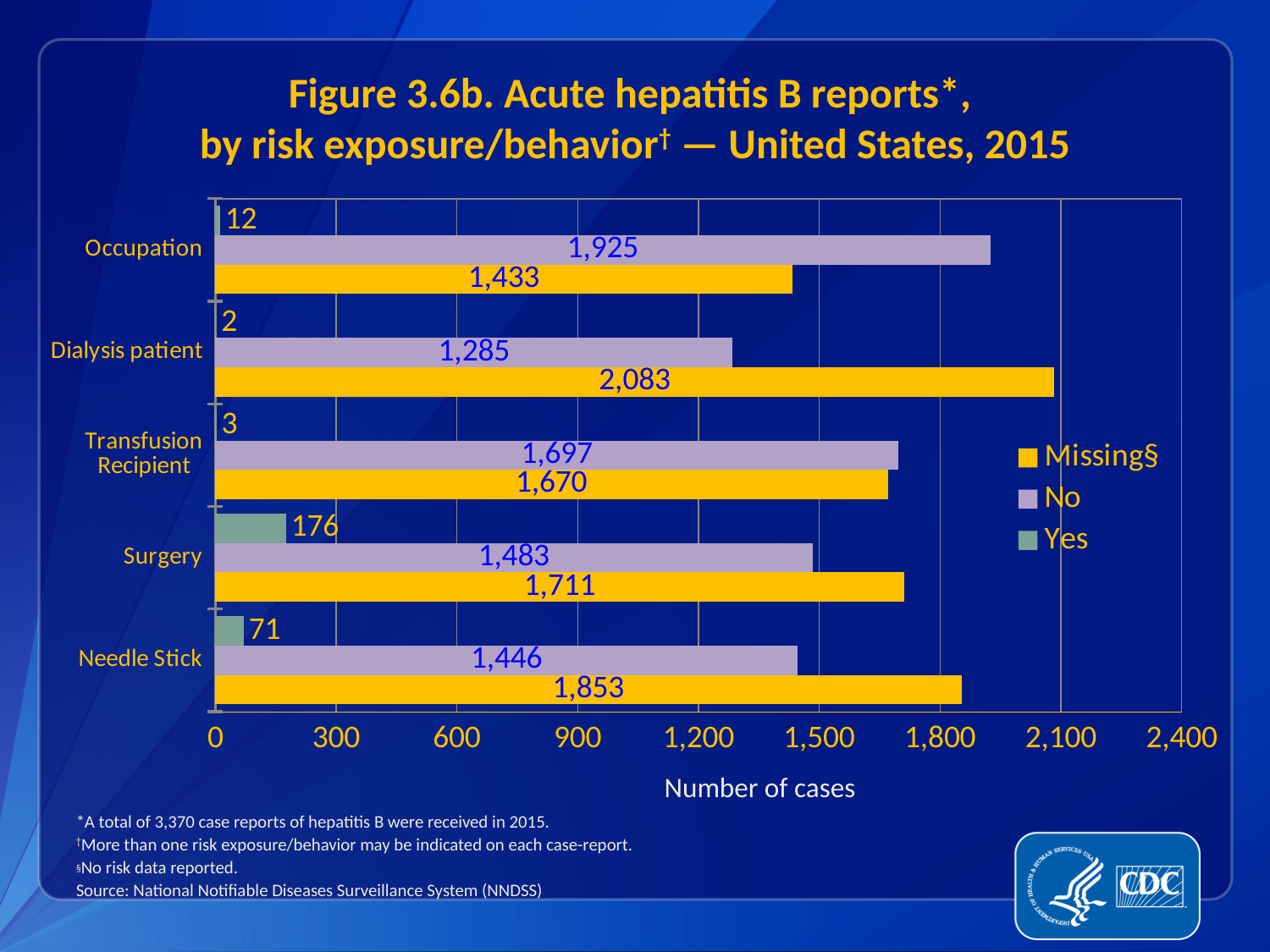
What is the number of cases in the "Missing§" series for Dialysis patient? 2,083 What is the number of cases in the "No" series for Occupation? 1,925 What kind of chart is shown on the slide? Bar chart How many risk exposure/behavior categories are shown on the chart? 5 Which risk exposure/behavior has the lowest value in the "No" series? Dialysis patient What is the difference between the "Missing§" and "No" values for Needle Stick? 407 What is the number of cases in the "Yes" series for Surgery? 176 What is the label of the x axis? Number of cases For Transfusion Recipient, which is larger: the "No" value or the "Missing§" value? No How many series does the legend list? 3 What is the total of the three series values for Needle Stick? 3,370 Which risk exposure/behavior has the highest value in the "Yes" series? Surgery